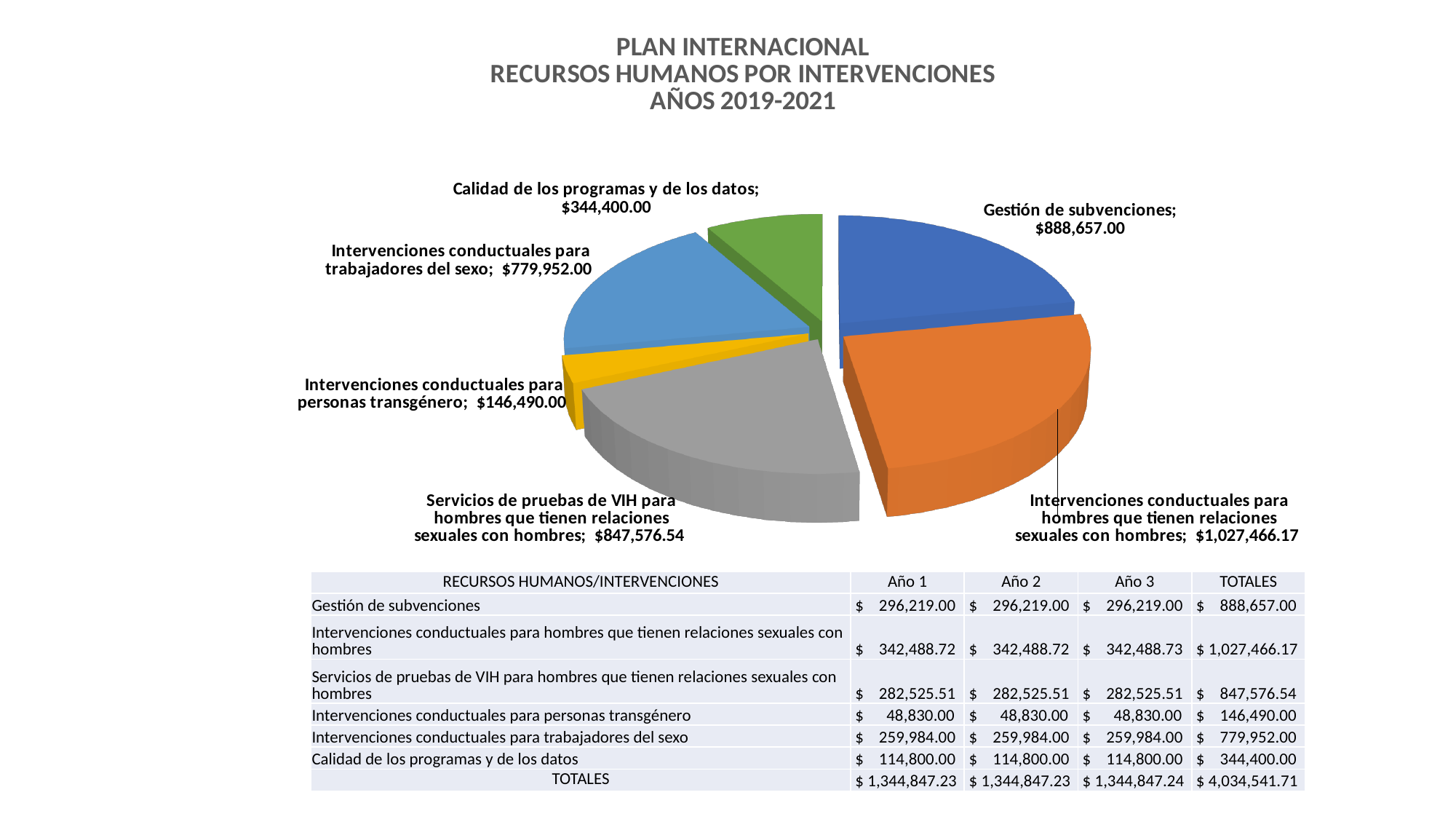
What is the value shown for Servicios de pruebas de VIH para hombres que tienen relaciones sexuales con hombres? $847,576.54 What is the value shown for Calidad de los programas y de los datos? $344,400.00 What is the value shown for Intervenciones conductuales para personas transgénero? $146,490.00 How many slices does the pie chart have? 6 What colour is the slice for Gestión de subvenciones? Blue Which category has the smallest slice in the pie chart? Intervenciones conductuales para personas transgénero Which category has the largest slice in the pie chart? Intervenciones conductuales para hombres que tienen relaciones sexuales con hombres What is the difference between the value for Intervenciones conductuales para trabajadores del sexo and the value for Calidad de los programas y de los datos? $435,552.00 What is the value shown for Gestión de subvenciones in the pie chart? $888,657.00 What type of chart is shown on the slide? Pie chart What is the difference between the value for Intervenciones conductuales para hombres que tienen relaciones sexuales con hombres and the value for Gestión de subvenciones? $138,809.17 Which is larger: the value for Gestión de subvenciones or the value for Intervenciones conductuales para trabajadores del sexo? Gestión de subvenciones